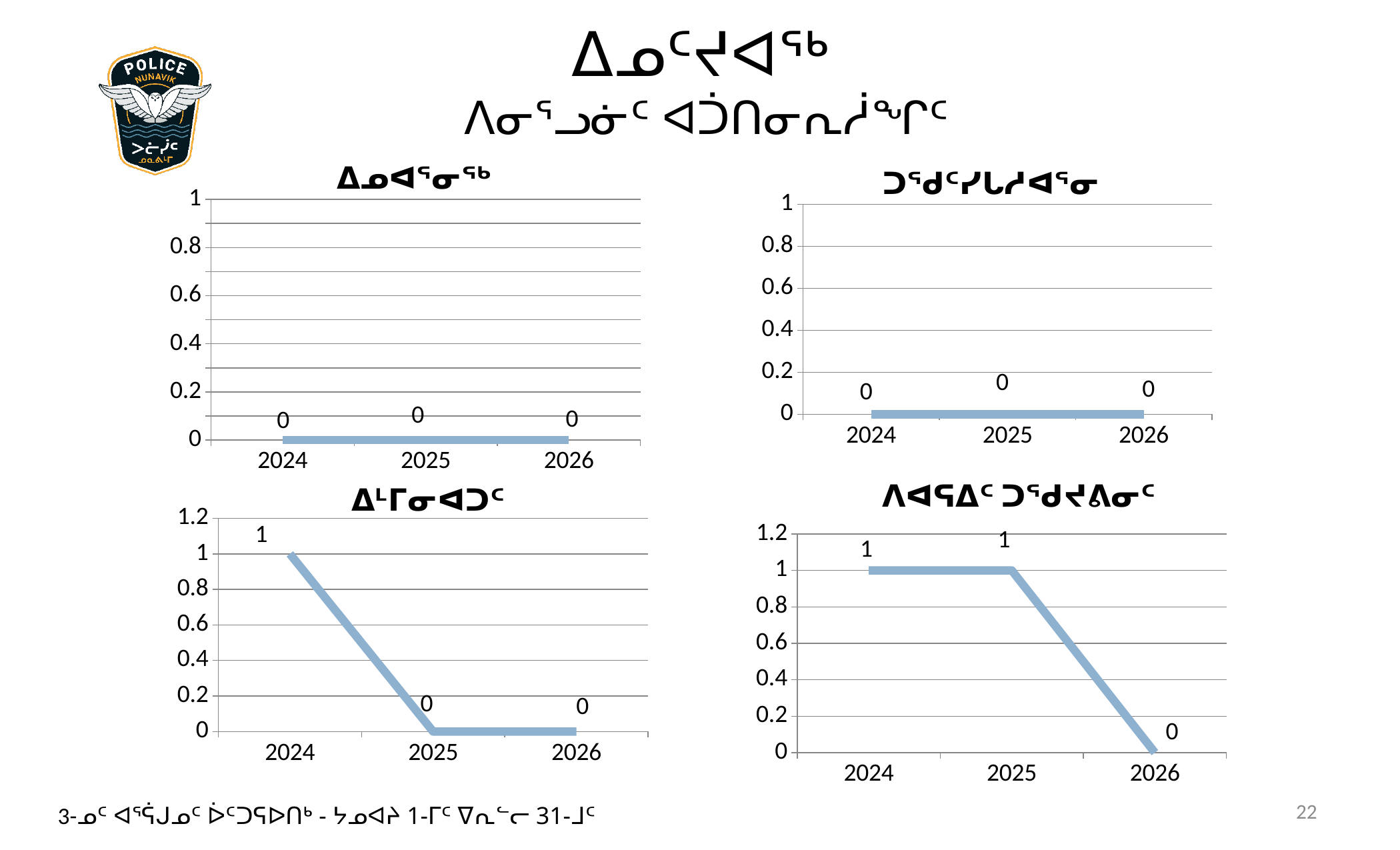
In the bottom-left chart, what is the value for 2024? 1 In the bottom-right chart, what is the difference between the values for 2025 and 2026? 1 What kind of chart is the bottom-right chart? line chart In the bottom-right chart, which year has the lowest value? 2026 In the bottom-left chart, which is larger, the value for 2024 or the value for 2026? 2024 In the bottom-right chart, what is the value for 2025? 1 In the bottom-left chart, what is the value for 2025? 0 In the bottom-right chart, what is the value for 2026? 0 In the top-right chart, what is the value for 2026? 0 In the bottom-left chart, which year has the highest value? 2024 How many years are plotted on the x axis of the top-right chart? 3 In the top-left chart, what is the value for 2025? 0